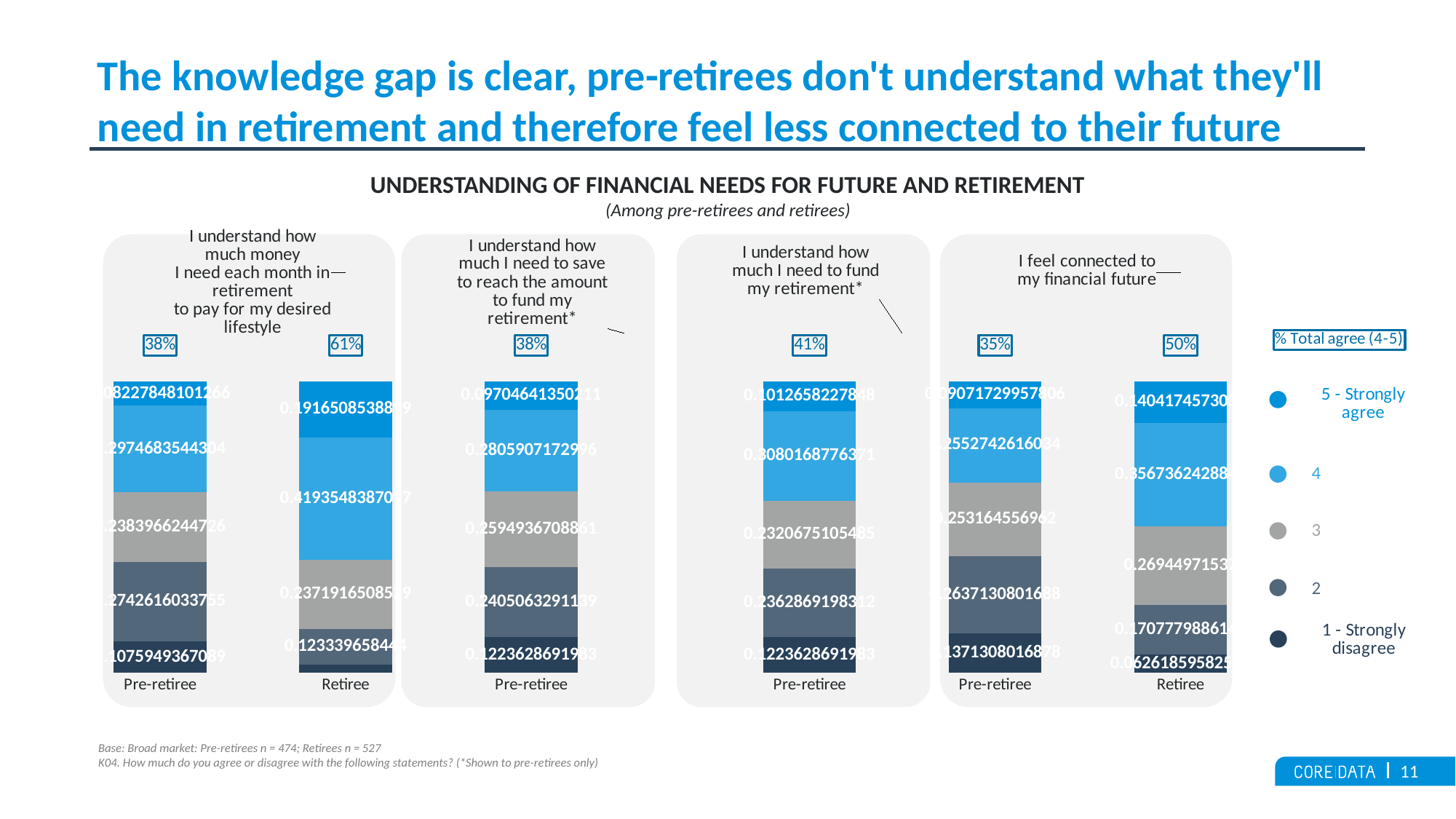
What is the % Total agree (4-5) for retirees on "I feel connected to my financial future"? 50% Which bar has the lowest % Total agree (4-5) on the chart? Pre-retiree, "I feel connected to my financial future" (35%) How many bars are plotted on the chart? 6 By how many percentage points does the % Total agree for retirees exceed that of pre-retirees on "I feel connected to my financial future"? 15 percentage points How many series does the legend list? 5 What is the difference in % Total agree between retirees and pre-retirees on "I understand how much money I need each month in retirement to pay for my desired lifestyle"? 23 percentage points What is the % Total agree (4-5) for pre-retirees on "I understand how much I need to fund my retirement"? 41% Which bar has the highest % Total agree (4-5) on the chart? Retiree, "I understand how much money I need each month in retirement to pay for my desired lifestyle" (61%) What is the % Total agree (4-5) for retirees on "I understand how much money I need each month in retirement to pay for my desired lifestyle"? 61% What kind of chart is shown on the slide? Stacked bar chart On "I feel connected to my financial future", who has the higher % Total agree: pre-retirees or retirees? Retirees What is the % Total agree (4-5) for pre-retirees on "I feel connected to my financial future"? 35%